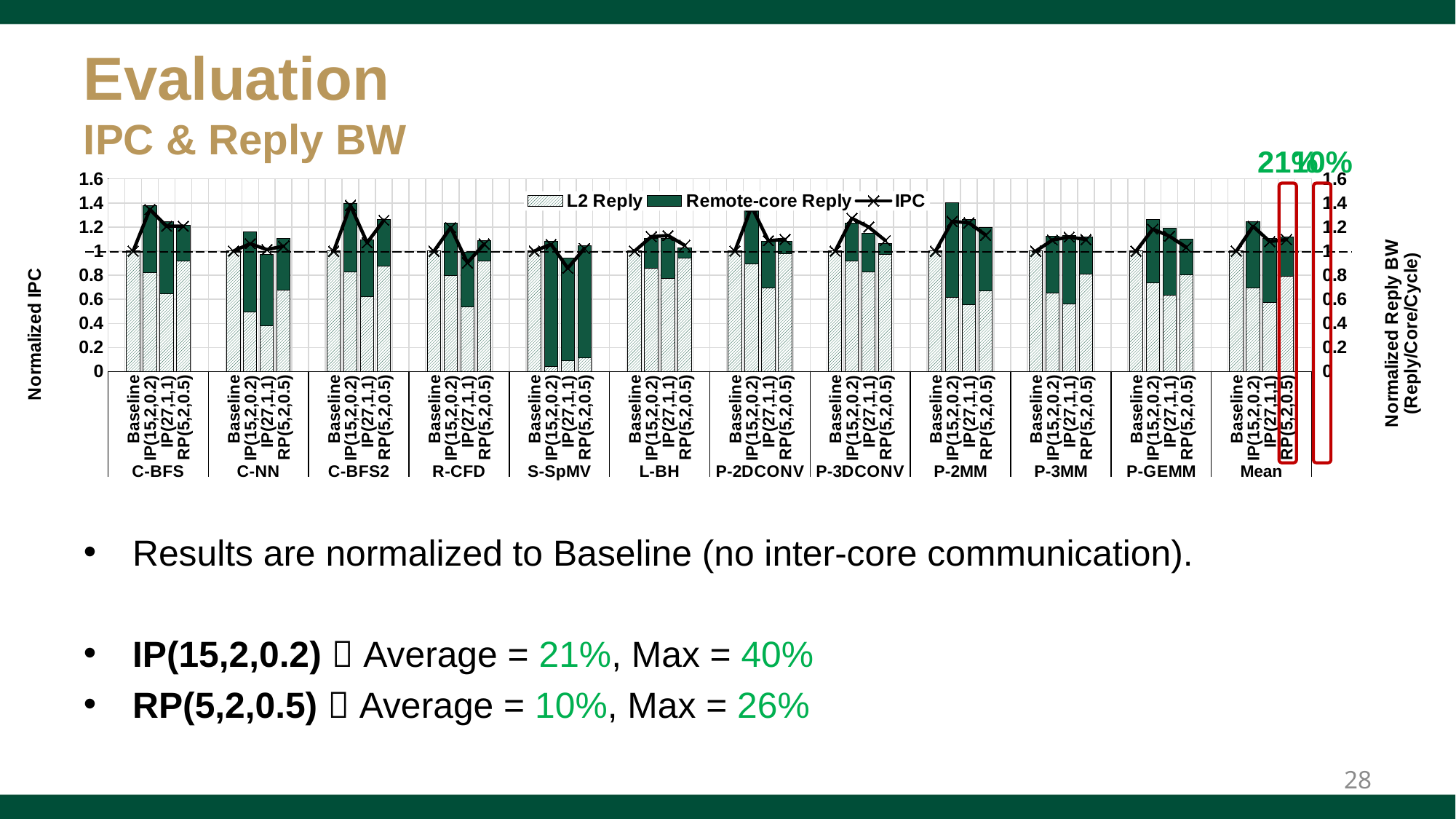
How many series does the chart legend list? 3 Is the L2 Reply value for IP(15,2,0.2) in the S-SpMV group greater or less than 0.2? less Is the total stacked bar height for IP(15,2,0.2) in the P-2MM group greater or less than 1.2? greater Is the IPC value for IP(15,2,0.2) in the C-BFS group greater or less than 1.2? greater What kind of chart is shown on the slide? A combined stacked bar and line chart How many configurations are plotted within each benchmark group in the chart? 4 What is the title of the left vertical axis of the chart? Normalized IPC Within the S-SpMV group, which configuration has the lowest IPC value? IP(27,1,1) Which series is drawn as a line with x markers in the chart? IPC How many benchmark groups (including Mean) are shown along the x axis of the chart? 12